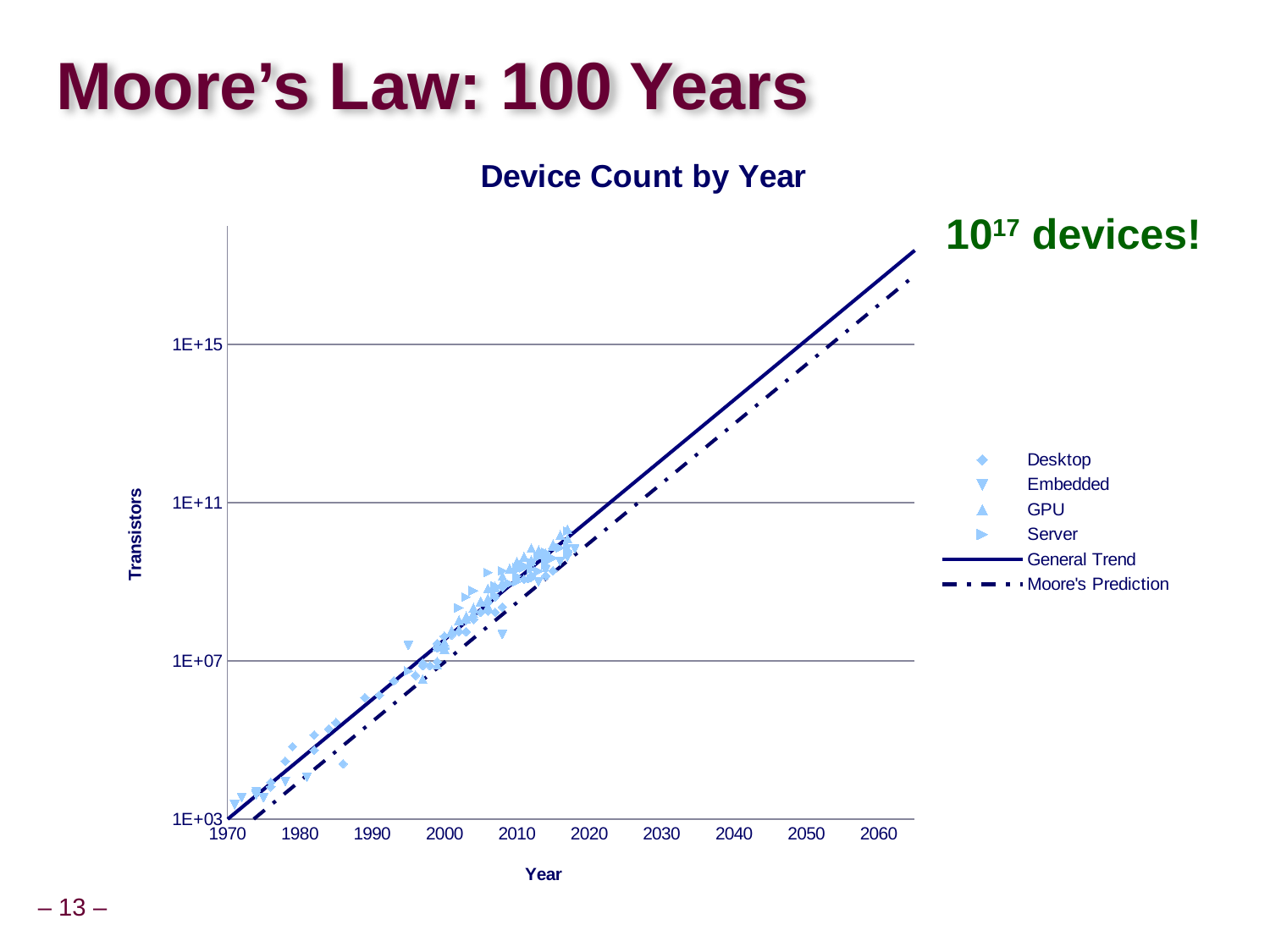
Is the General Trend value at 2040 greater or less than 1E+15? less What is the last year labelled on the x axis? 2060 What is the first year shown on the x axis? 1970 At 2040, which line is higher: General Trend or Moore's Prediction? General Trend How many entries does the chart's legend list? 6 Is the General Trend value at 1990 greater or less than 1E+07? less What is the title of the chart? Device Count by Year What is the label of the y axis? Transistors Is the General Trend value at 2030 greater or less than 1E+11? greater Do the General Trend values rise or fall as the year increases? rise What kind of chart is shown on the slide? scatter chart